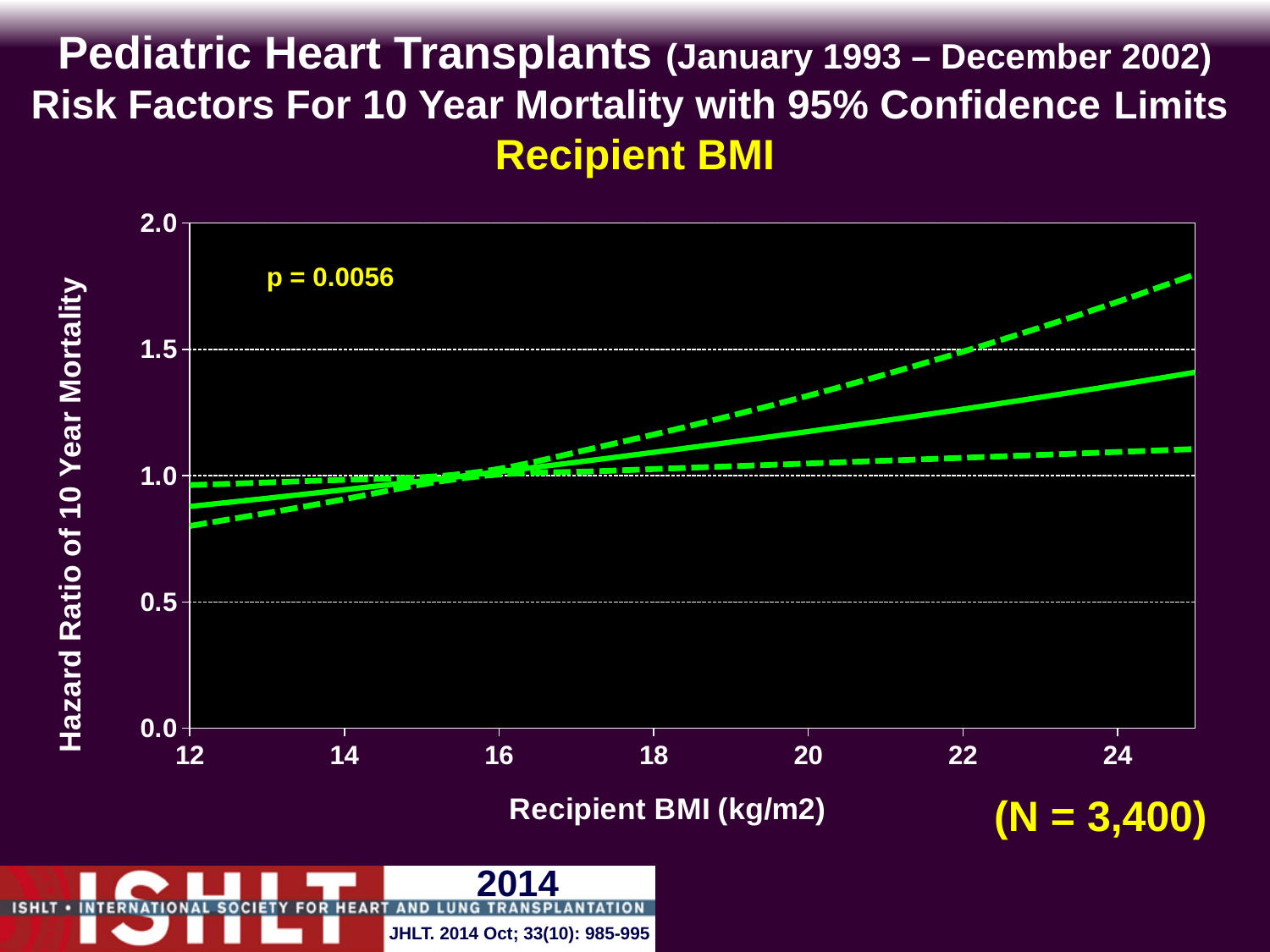
Is the hazard ratio (solid line) at a Recipient BMI of 12 greater or less than 1.0? less What p-value is shown on the chart? p = 0.0056 Is the upper 95% confidence limit (upper dashed line) at a Recipient BMI of 24 greater or less than 1.5? greater Is the hazard ratio (solid line) at a Recipient BMI of 20 greater or less than 1.5? less Does the solid hazard ratio line rise or fall as Recipient BMI increases from 12 to 24? rise What kind of chart is shown on the slide? line chart What is the sample size (N) shown on the slide? N = 3,400 How many lines are plotted on the chart? 3